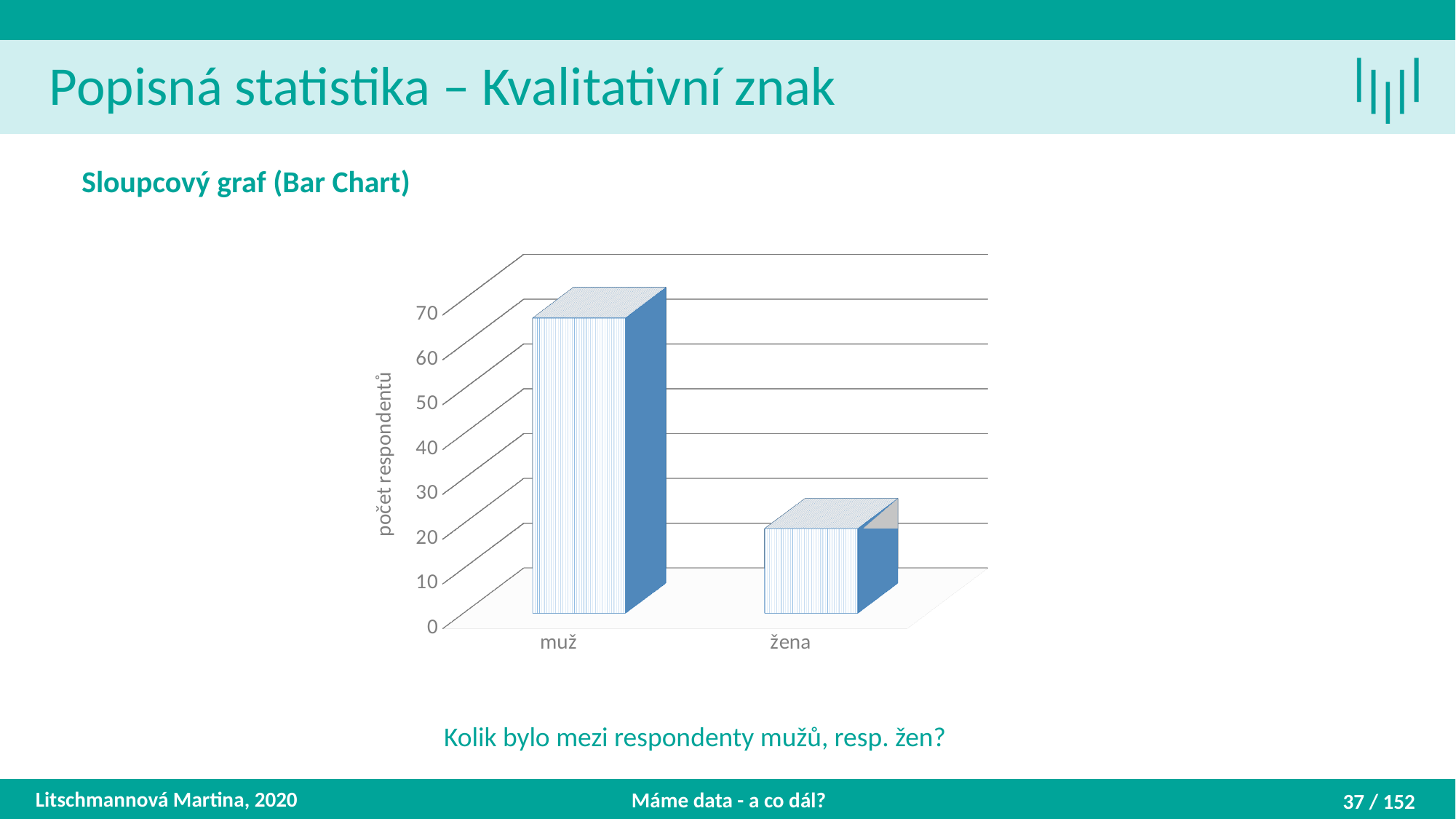
What is the highest tick value shown on the vertical axis of the chart? 70 How many categories are shown on the x axis of the chart? 2 Is the value for žena greater or less than 10? greater What is the label of the vertical axis of the chart? počet respondentů Is the value for muž greater or less than 30? greater Which category has the lowest value in the chart? žena Which category has the highest value in the chart? muž Is the value for muž greater or less than 50? greater What kind of chart is shown on the slide? bar chart Which category has the larger value, muž or žena? muž